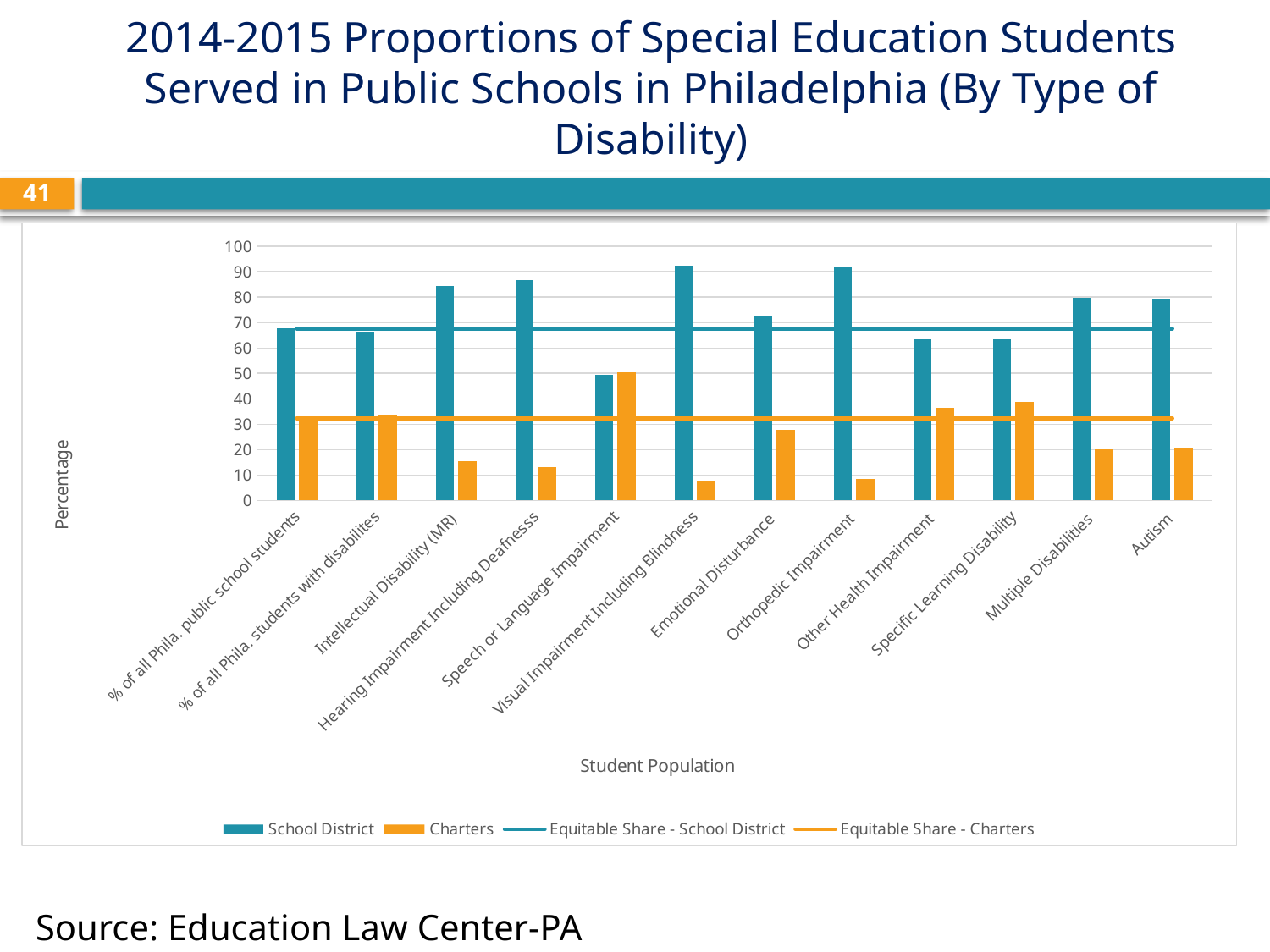
What is the title of the x axis of the chart? Student Population What is the title of the y axis of the chart? Percentage How many series does the chart's legend list? 4 For Autism, which is larger: the School District value or the Charters value? School District Is the Charters value for Visual Impairment Including Blindness greater or less than 20? less What kind of chart is shown on the slide? combination bar and line chart How many categories are shown along the x axis of the chart? 12 Is the School District value for Intellectual Disability (MR) greater or less than 80? greater Is the Charters value for Other Health Impairment greater or less than 30? greater Which category has the highest Charters value? Speech or Language Impairment Which category has the lowest School District value? Speech or Language Impairment